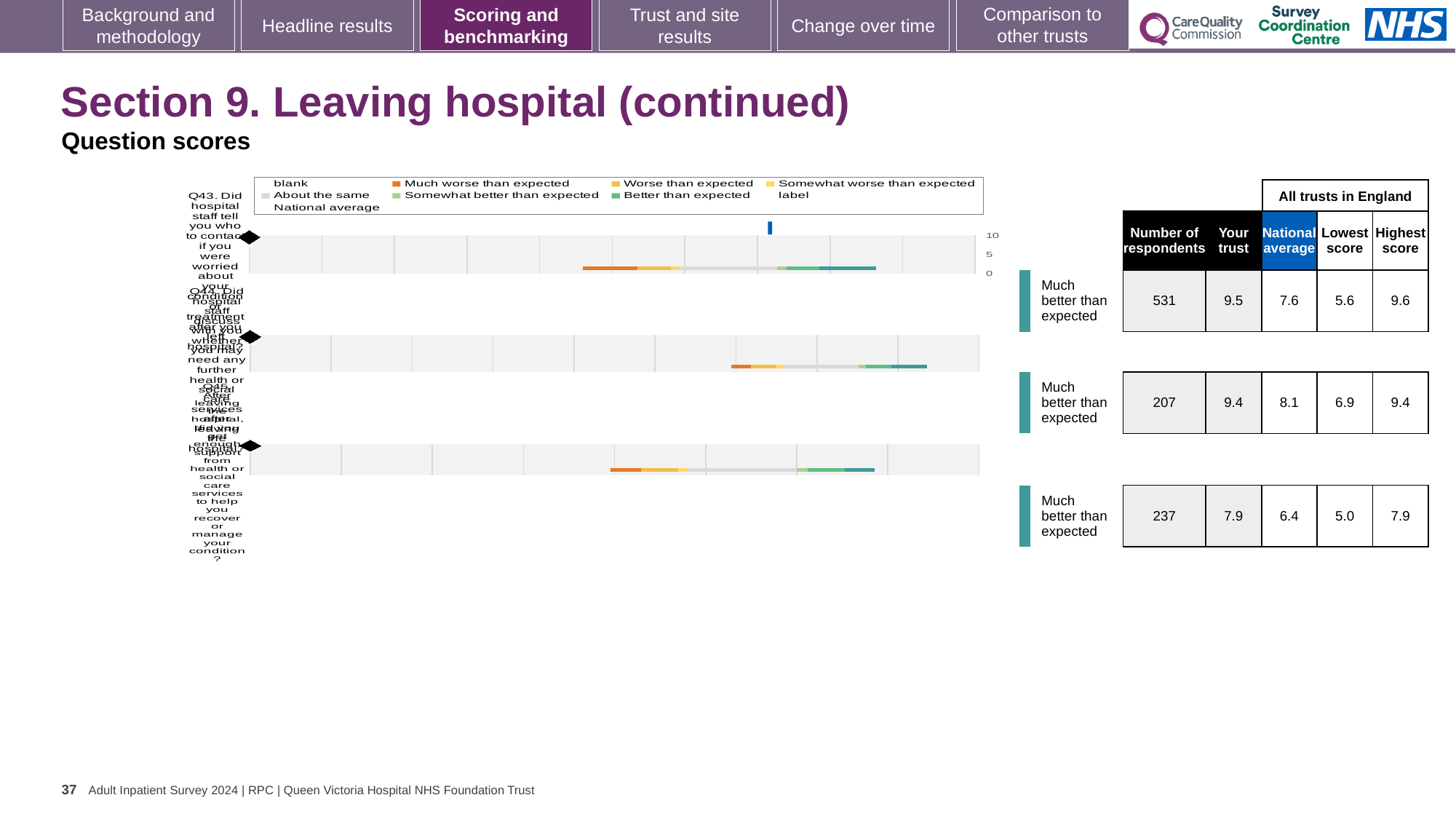
For the top chart (Q43), how many respondents are listed? 531 For the top chart (Q43), what is the 'Your trust' score shown in the table? 9.5 For the middle chart, what is the highest score among all trusts in England? 9.4 For the top chart (Q43), what is the national average score? 7.6 For the bottom chart, what is the 'Your trust' score? 7.9 What kind of chart is used for the question scores on this slide? bar chart Which legend entry is shown in orange for the question score charts? Much worse than expected How many question score charts are shown on the slide? 3 For the middle chart, what is the lowest score among all trusts in England? 6.9 What is the highest value shown on the score axis of the charts? 10 For the bottom chart, what is the difference between the 'Your trust' score and the national average? 1.5 For the top chart (Q43), is the 'Your trust' score higher or lower than the national average? higher